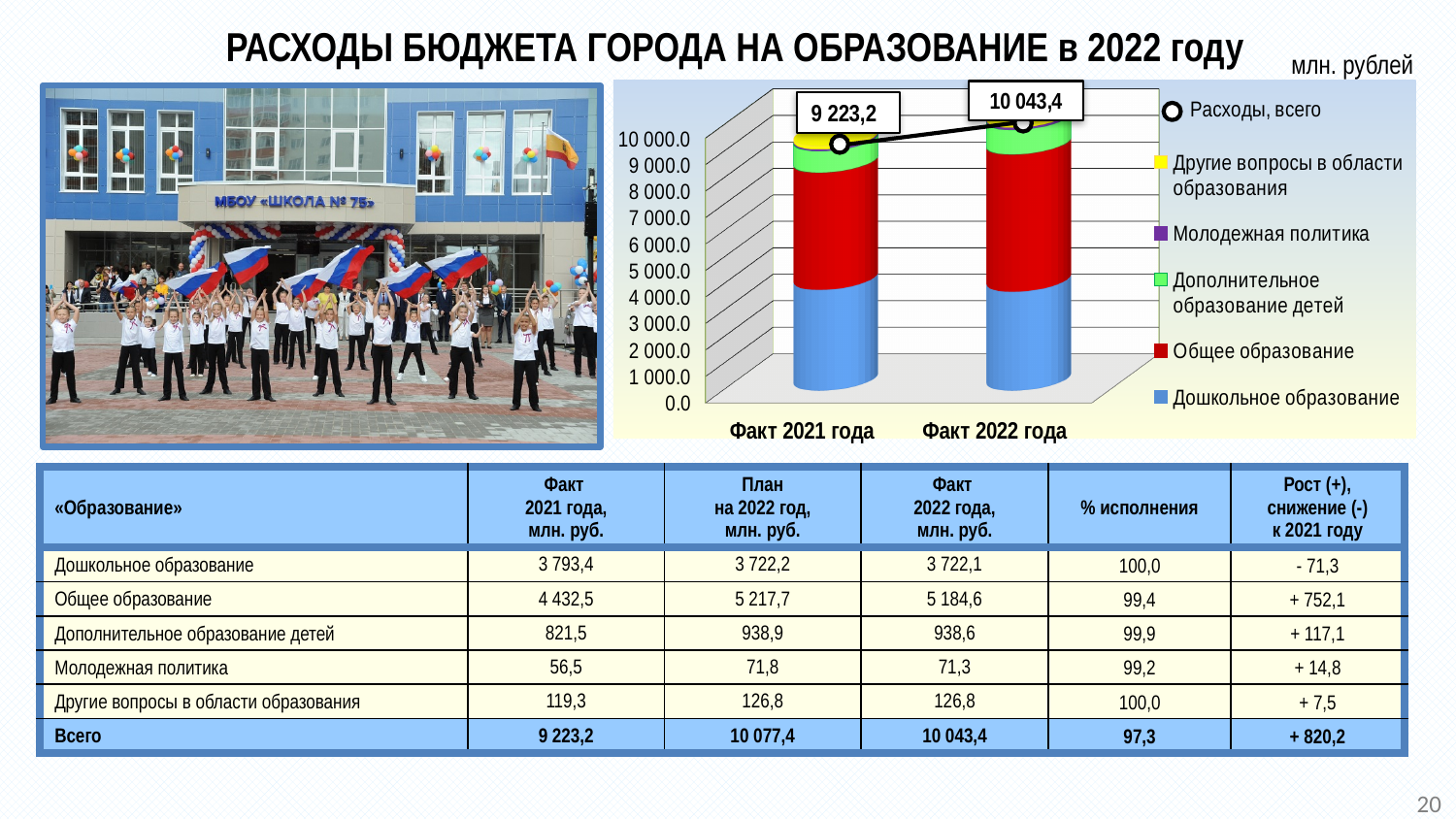
How many categories are shown on the x axis of the chart? 2 Which category has the lowest total expenditure? Факт 2021 года By how much does «Расходы, всего» for «Факт 2022 года» exceed the value for «Факт 2021 года»? 820,2 Which category has the higher total expenditure, «Факт 2021 года» or «Факт 2022 года»? Факт 2022 года What kind of chart is shown on the slide? Stacked bar chart with a line Is the value of «Расходы, всего» for «Факт 2021 года» greater or less than 9 000? greater What unit of measurement is indicated for the chart? млн. рублей What is the value of «Расходы, всего» for «Факт 2022 года»? 10 043,4 Does the total expenditure rise or fall from «Факт 2021 года» to «Факт 2022 года»? Rises What is the value of «Расходы, всего» for «Факт 2021 года»? 9 223,2 How many entries does the chart legend list? 6 Which colour represents «Общее образование» in the chart legend? Red